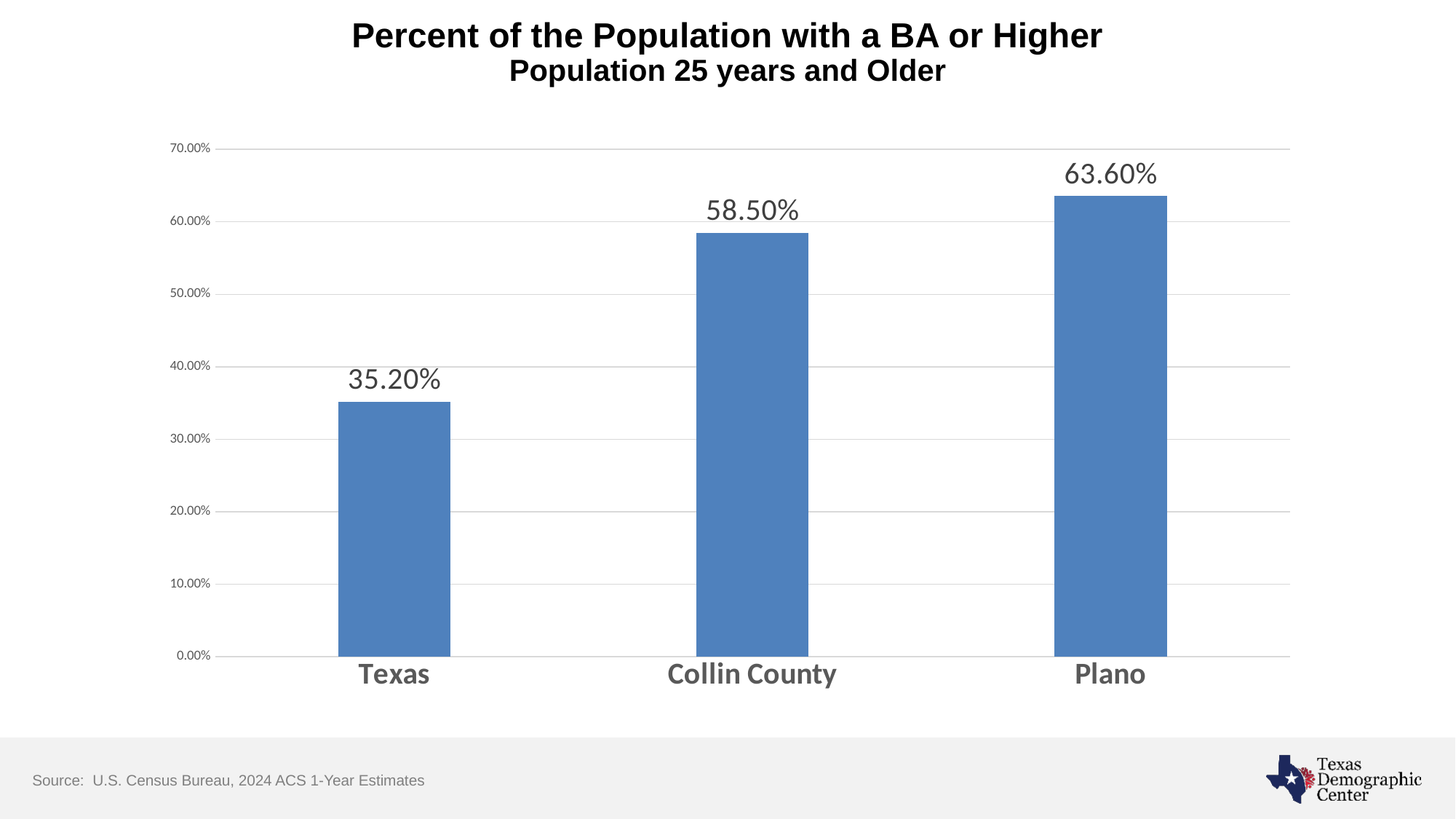
What is the value for Collin County? 58.50% What kind of chart is shown on the slide? bar chart What is the difference between the values for Plano and Texas? 28.40% What is the value for Plano? 63.60% Which category has the lowest value? Texas Is the value for Texas greater or less than 40.00%? less What is the difference between the values for Plano and Collin County? 5.10% Which category has the highest value? Plano Which is larger, the value for Collin County or the value for Texas? Collin County What is the title of the chart? Percent of the Population with a BA or Higher What is the value for Texas? 35.20% How many categories are shown on the chart? 3